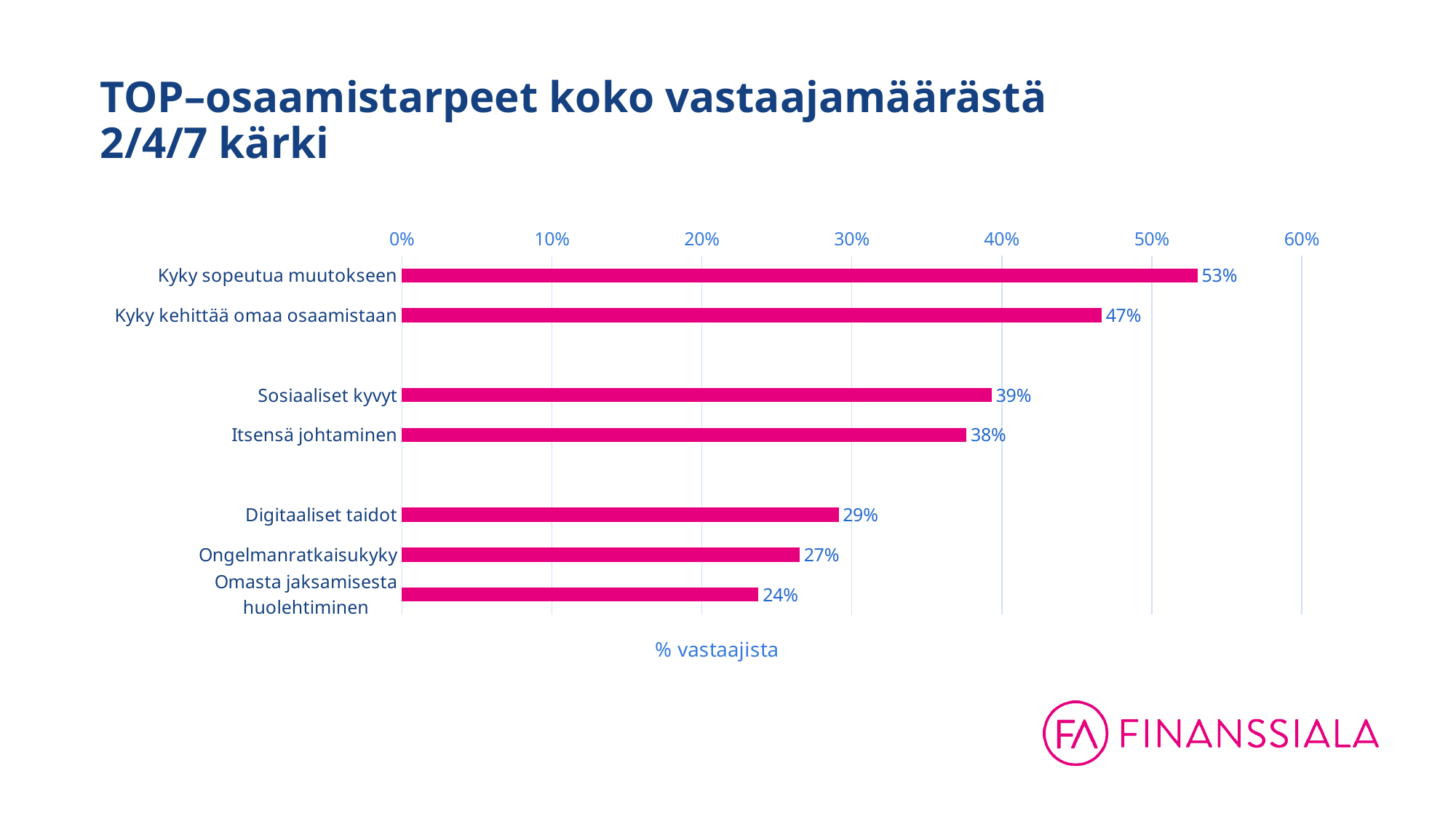
Which is larger, Itsensä johtaminen or Digitaaliset taidot? Itsensä johtaminen What is the difference between Sosiaaliset kyvyt and Ongelmanratkaisukyky? 12% What is the value for Kyky sopeutua muutokseen? 53% Which category has the highest value? Kyky sopeutua muutokseen What kind of chart is shown on the slide? Bar chart Is the value for Kyky kehittää omaa osaamistaan greater or less than 40%? greater Which category has the lowest value? Omasta jaksamisesta huolehtiminen What is the value for Digitaaliset taidot? 29% How many categories are shown in the chart? 7 What is the label of the horizontal axis? % vastaajista What is the difference between Kyky sopeutua muutokseen and Kyky kehittää omaa osaamistaan? 6% What is the value for Omasta jaksamisesta huolehtiminen? 24%